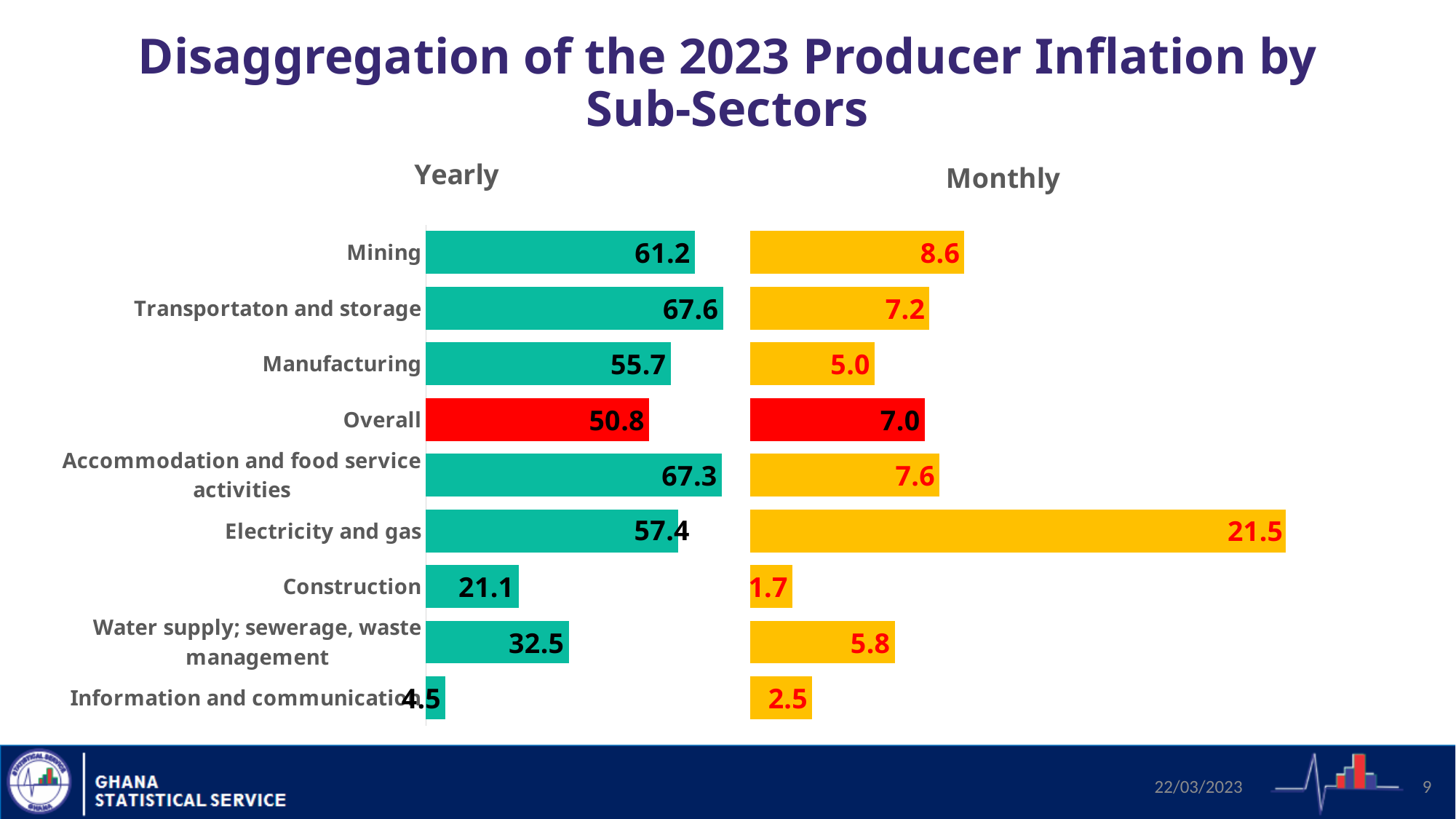
In the Yearly chart, which sub-sector has the lowest value? Information and communication In the Monthly chart, which sub-sector has the lowest value? Construction In the Yearly chart, what is the value for Overall? 50.8 What type of chart is the Monthly chart? Bar chart In the Monthly chart, what is the value for Electricity and gas? 21.5 In the Monthly chart, what is the difference between Mining and Overall? 1.6 In the Yearly chart, what is the value for Mining? 61.2 How many sub-sector categories are shown in the Yearly chart? 9 In the Monthly chart, what is the value for Construction? 1.7 In the Yearly chart, which is larger, Electricity and gas or Manufacturing? Electricity and gas In the Yearly chart, what is the difference between Transportaton and storage and Manufacturing? 11.9 In the Monthly chart, which sub-sector has the highest value? Electricity and gas